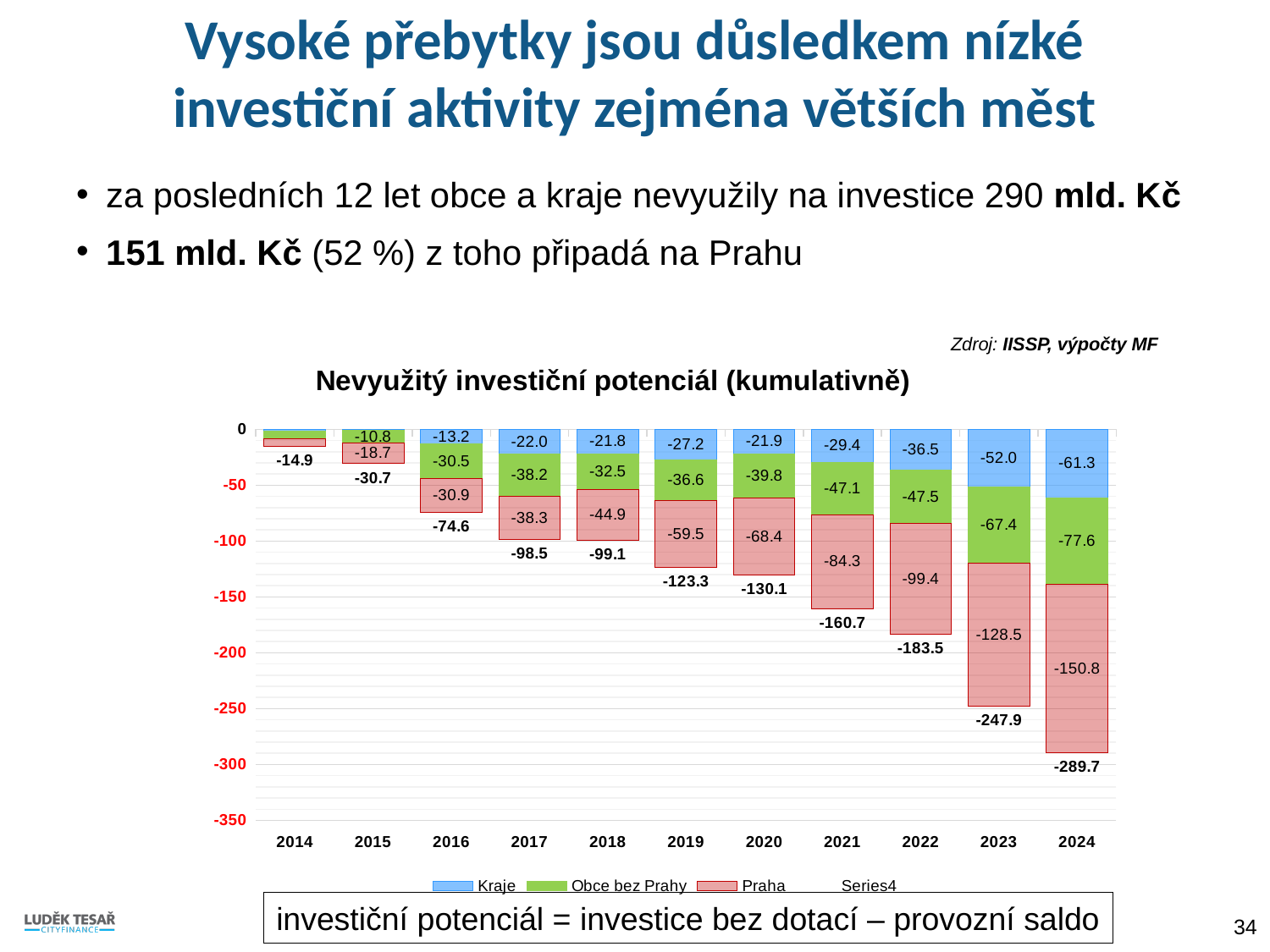
In 2022, which segment is larger in magnitude: Praha or Obce bez Prahy? Praha What is the difference between the total for 2024 and the total for 2023? 41.8 What is the total labelled for the 2021 bar? -160.7 What is the total labelled for the 2024 bar? -289.7 What is the value of the Obce bez Prahy segment for 2019? -36.6 What is the value of the Praha segment for 2024? -150.8 Which year has the lowest (most negative) total value? 2024 What is the value of the Kraje segment for 2023? -52.0 How many entries does the legend list? 4 How many years are shown on the x axis? 11 What type of chart is shown? Stacked bar chart Which year has the total value closest to zero? 2014